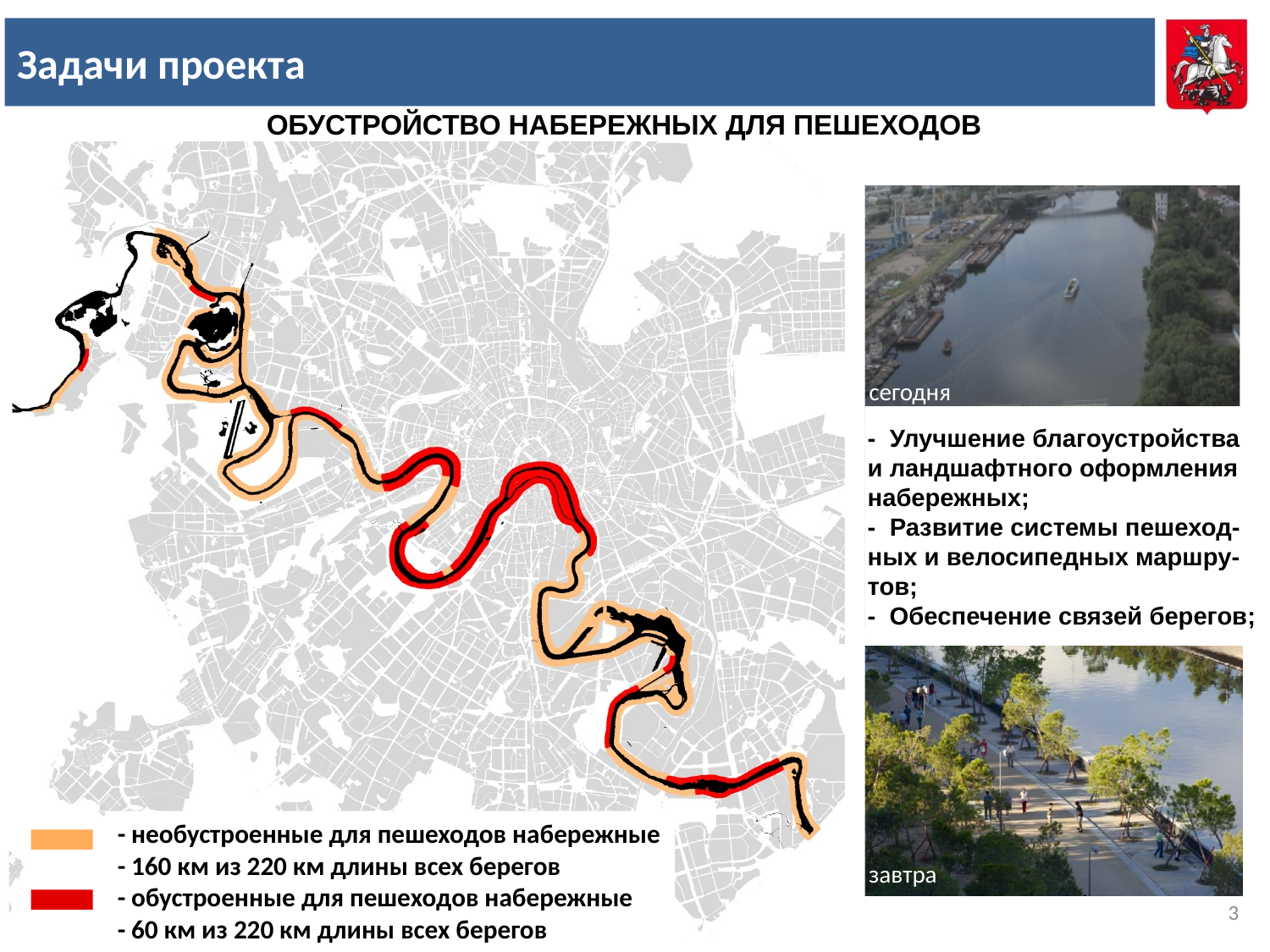
According to the map legend, how many kilometres of embankments are improved for pedestrians (обустроенные)? 60 км What colour marks the embankments improved for pedestrians on the map? red According to the map legend, how many kilometres of embankments are not improved for pedestrians (необустроенные)? 160 км Which category in the map legend has the greater length: improved or unimproved embankments? необустроенные (unimproved) How many categories does the map legend list? 2 What is the combined length of the improved and unimproved embankments shown in the legend? 220 км By how many kilometres do the unimproved embankments exceed the improved ones? 100 км What kind of visualisation is shown on the left of the slide? a map What is the total length of all river banks stated in the map legend? 220 км What colour marks the embankments not improved for pedestrians on the map? light orange